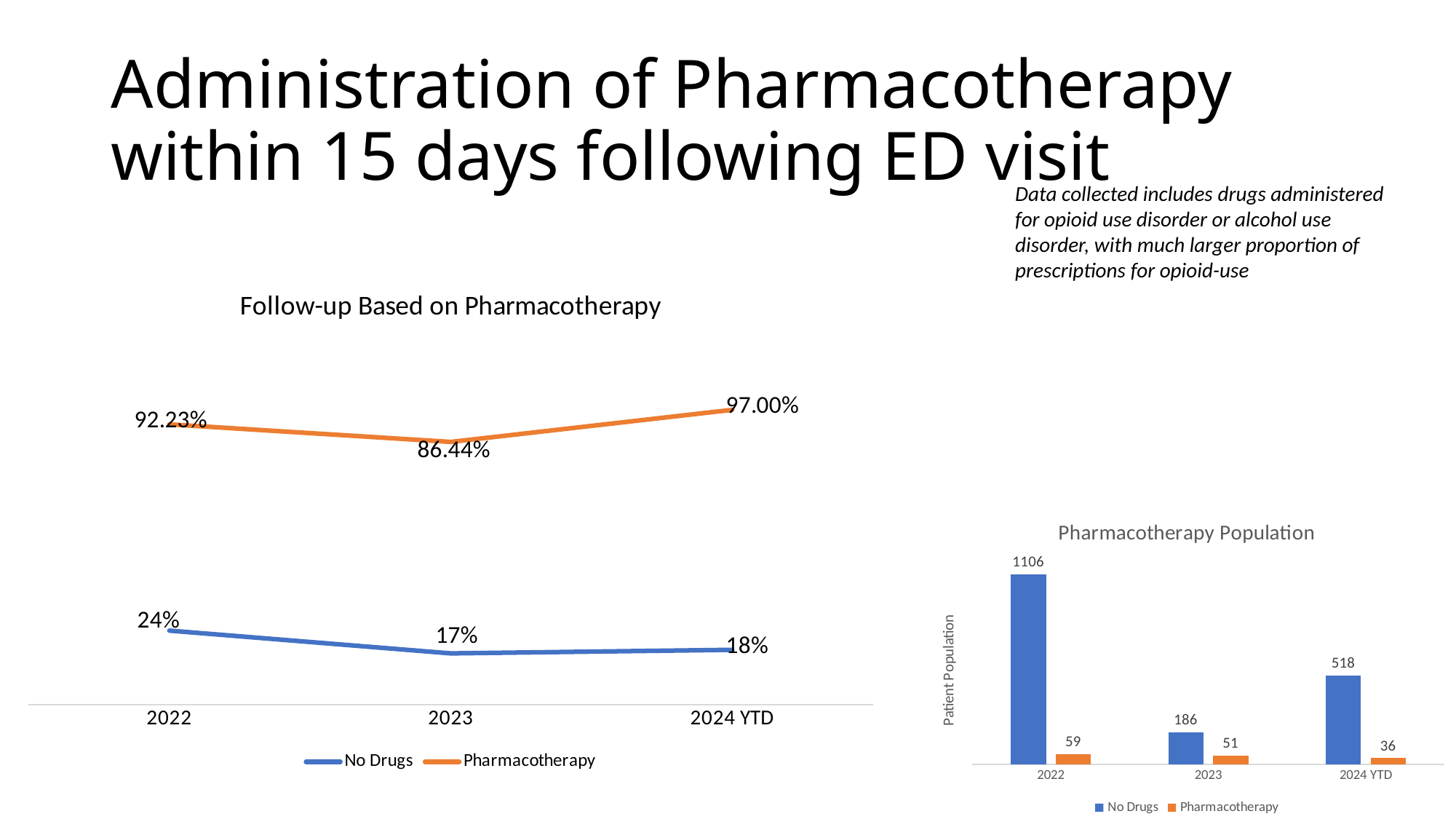
In the 'Follow-up Based on Pharmacotherapy' chart, what is the No Drugs value for 2022? 24% What kind of chart is 'Follow-up Based on Pharmacotherapy'? Line chart In the 'Follow-up Based on Pharmacotherapy' chart, in which year is the Pharmacotherapy value highest? 2024 YTD In the 'Pharmacotherapy Population' chart, what is the difference between the No Drugs values for 2022 and 2023? 920 What kind of chart is 'Pharmacotherapy Population'? Bar chart In the 'Pharmacotherapy Population' chart, which is larger: the No Drugs value for 2023 or the No Drugs value for 2024 YTD? 2024 YTD In the 'Follow-up Based on Pharmacotherapy' chart, what is the difference between the Pharmacotherapy and No Drugs values for 2024 YTD? 79.00% In the 'Pharmacotherapy Population' chart, what is the No Drugs value for 2022? 1106 In the 'Follow-up Based on Pharmacotherapy' chart, what is the Pharmacotherapy value for 2023? 86.44% How many series does the legend of the 'Follow-up Based on Pharmacotherapy' chart list? 2 In the 'Pharmacotherapy Population' chart, what is the Pharmacotherapy value for 2024 YTD? 36 In the 'Follow-up Based on Pharmacotherapy' chart, in which year is the No Drugs value lowest? 2023